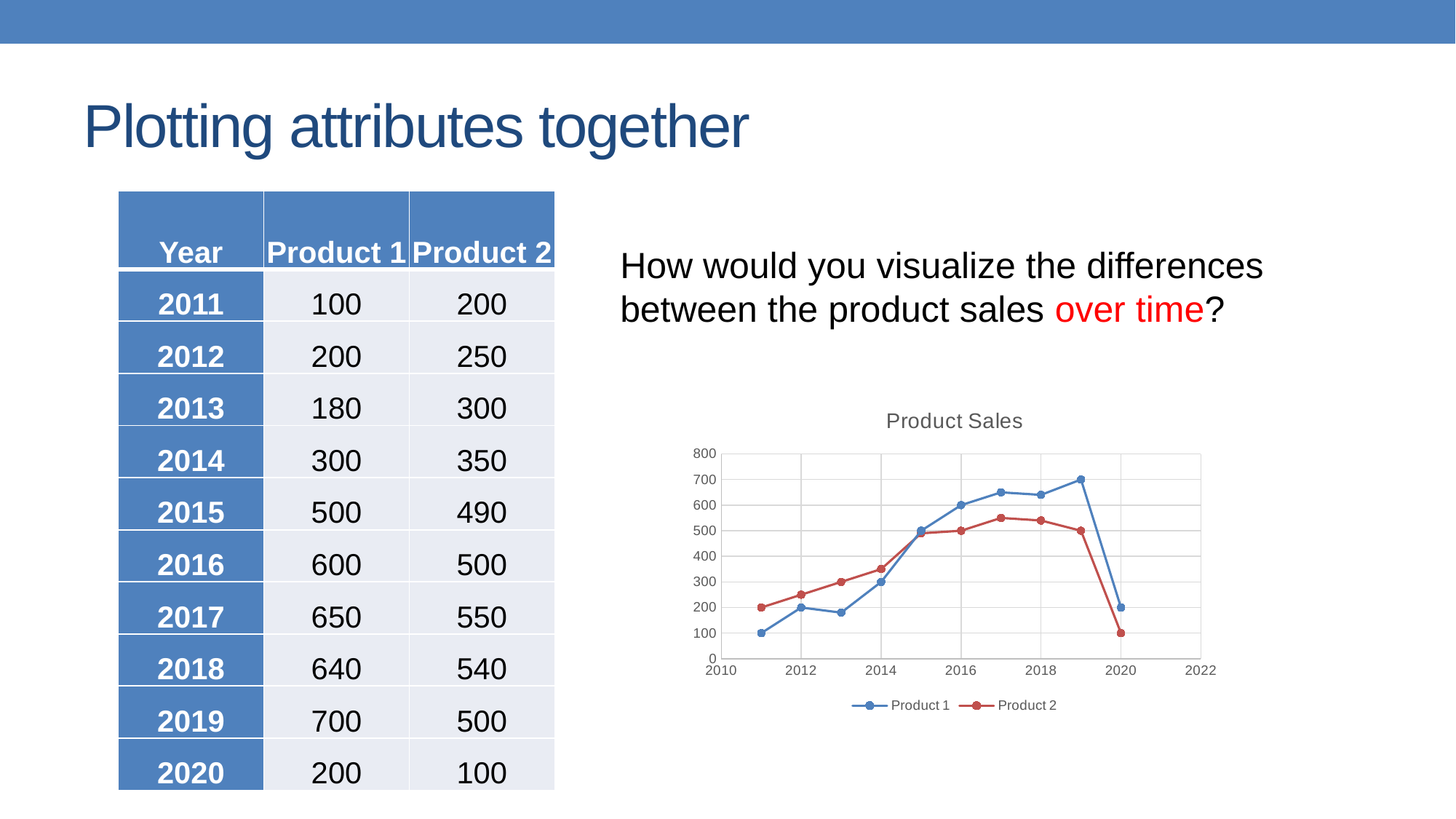
What kind of chart is the Product Sales chart? line chart In the Product Sales chart, what is the difference between Product 1 and Product 2 in 2019? 200 How many years are plotted for each series in the Product Sales chart? 10 In the Product Sales chart, what is the value for Product 2 in 2017? 550 In the Product Sales chart, which series has the larger value in 2013, Product 1 or Product 2? Product 2 How many series does the legend of the Product Sales chart list? 2 In the Product Sales chart, is the value for Product 1 in 2016 greater or less than 500? greater In the Product Sales chart, in which year does Product 2 have its lowest value? 2020 What is the title of the chart on the slide? Product Sales In the Product Sales chart, what is the value for Product 1 in 2011? 100 In the Product Sales chart, what is the value for Product 1 in 2019? 700 In the Product Sales chart, in which year does Product 1 reach its highest value? 2019